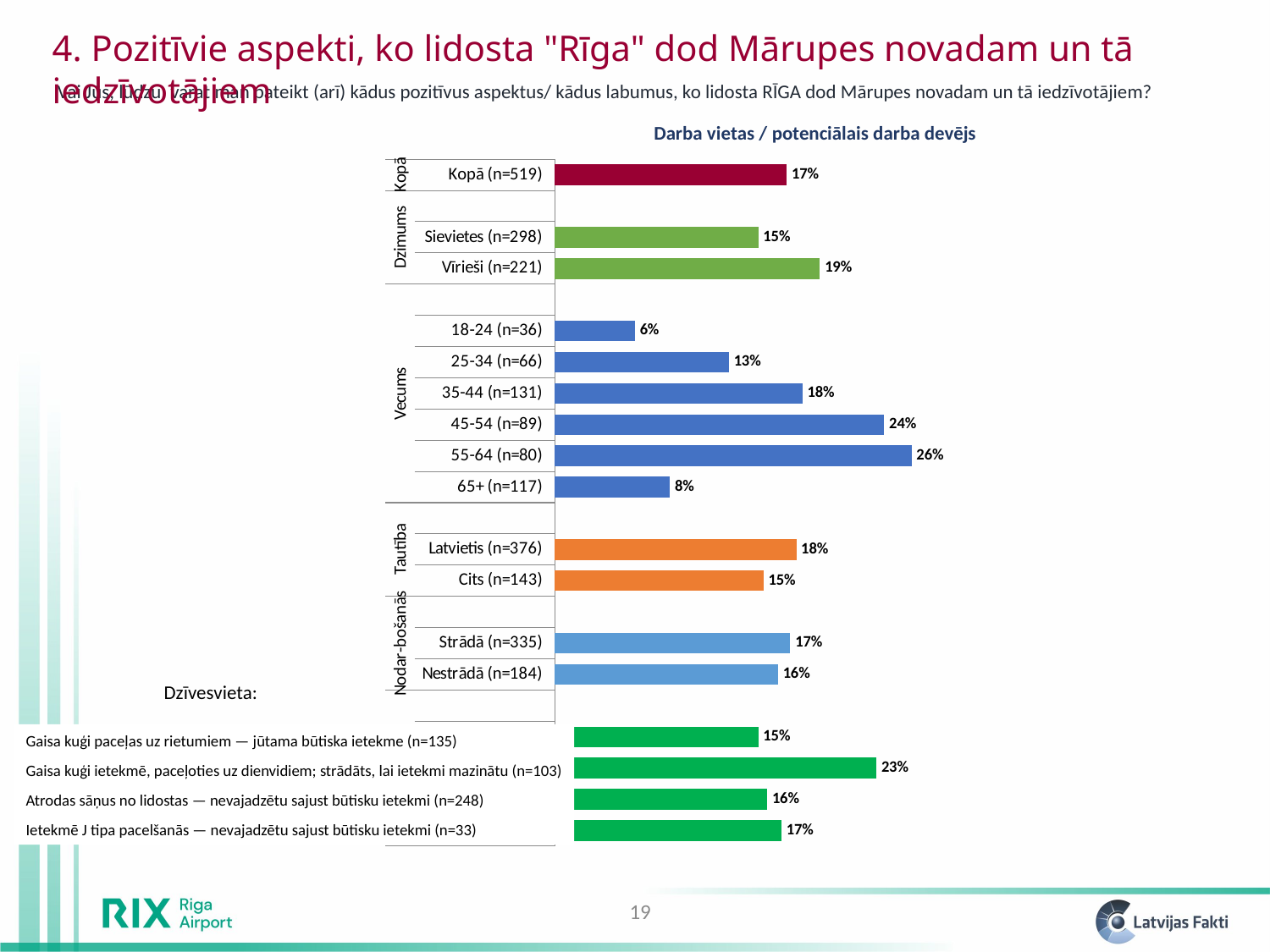
What is the difference between the values for 55-64 (n=80) and 65+ (n=117)? 18% Which category has the lowest value on the chart? 18-24 (n=36) What is the value for the Dzīvesvieta category 'Gaisa kuģi ietekmē, paceļoties uz dienvidiem; strādāts, lai ietekmi mazinātu (n=103)'? 23% What is the title of the chart? Darba vietas / potenciālais darba devējs What type of chart is shown on the slide? Bar chart What is the value for Nestrādā (n=184)? 16% What is the difference between the values for Vīrieši (n=221) and Sievietes (n=298)? 4% What is the value for Kopā (n=519)? 17% Which category has the highest value on the chart? 55-64 (n=80) Which is larger, the value for Latvietis (n=376) or Cits (n=143)? Latvietis (n=376) What is the value for Vīrieši (n=221)? 19% What is the value for 45-54 (n=89)? 24%